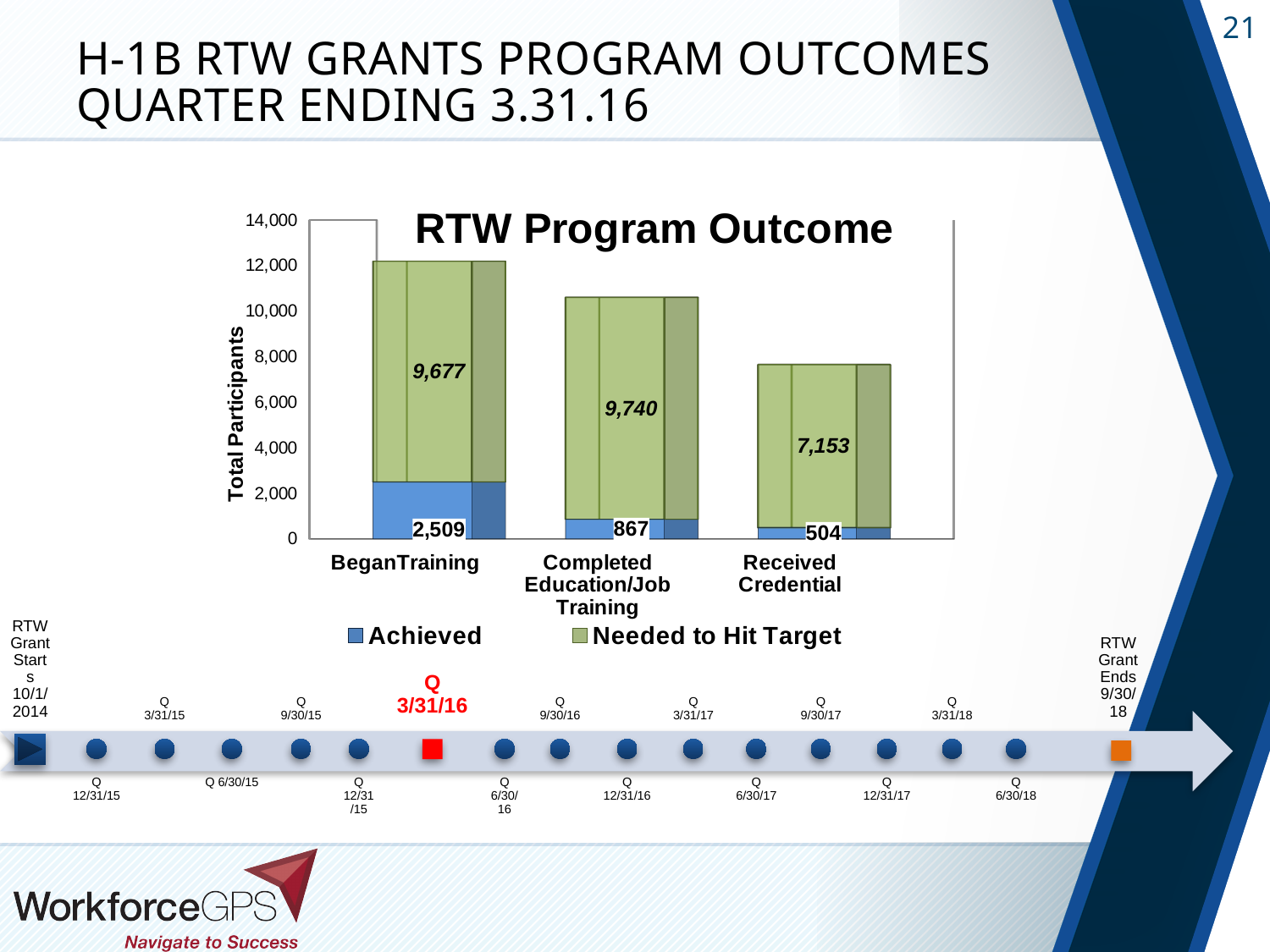
What is the Achieved value for Began Training? 2,509 How many categories are shown on the x axis of the RTW Program Outcome chart? 3 What type of chart is the RTW Program Outcome chart? Stacked bar chart What is the Needed to Hit Target value for Received Credential? 7,153 What is the Needed to Hit Target value for Completed Education/Job Training? 9,740 What is the Achieved value for Received Credential? 504 What is the y-axis title of the RTW Program Outcome chart? Total Participants What is the difference between the Achieved values for Began Training and Completed Education/Job Training? 1,642 Which category has the lowest Needed to Hit Target value? Received Credential How many series does the legend of the RTW Program Outcome chart list? 2 What is the total of the stacked bar for Received Credential? 7,657 Which category has the highest Achieved value? Began Training